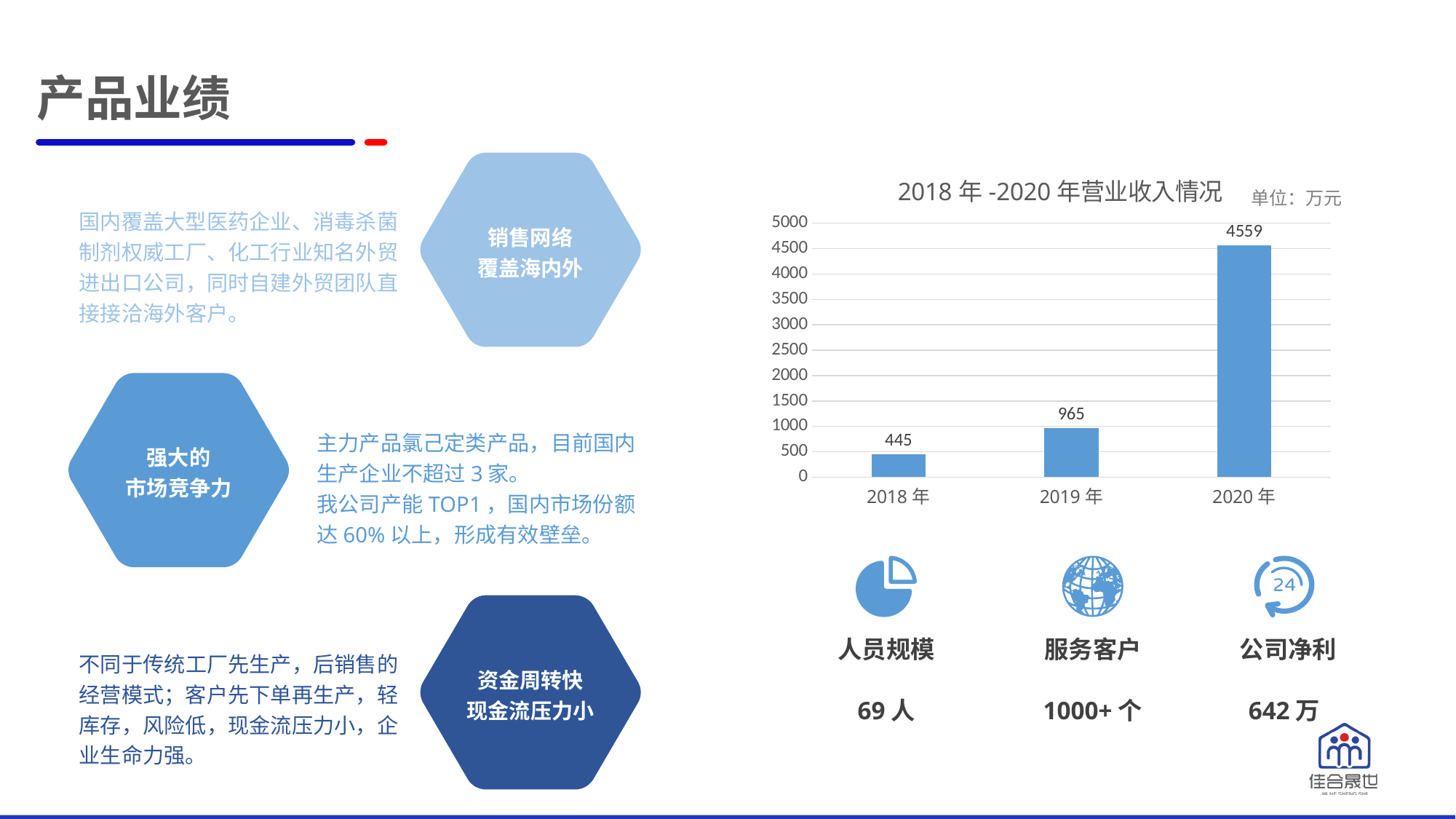
Which year has the lowest value in the chart? 2018 年 What is the difference between the values for 2020 年 and 2019 年? 3594 How many years are shown in the chart? 3 What is the value for 2018 年 in the chart? 445 What is the value for 2019 年 in the chart? 965 Is the value for 2020 年 greater or less than 4000? greater Which is larger, the value for 2019 年 or the value for 2018 年? 2019 年 Do the values rise or fall from 2018 年 to 2020 年? rise What is the difference between the values for 2019 年 and 2018 年? 520 Which year has the highest value in the chart? 2020 年 What kind of chart is shown on the slide? bar chart What is the value for 2020 年 in the chart? 4559